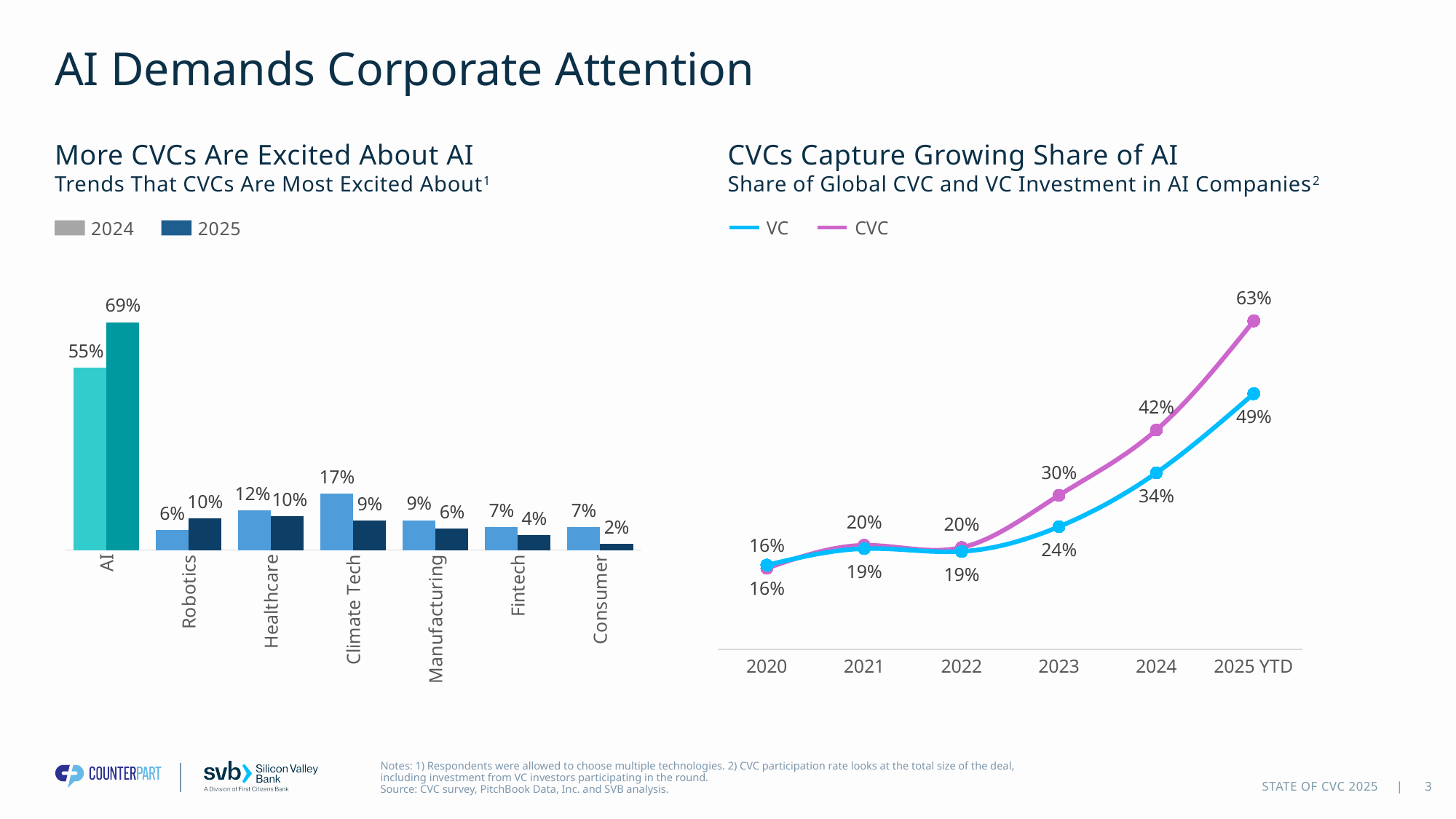
In the 'CVCs Capture Growing Share of AI' chart, what is the difference between the CVC and VC values in 2024? 8% In the 'More CVCs Are Excited About AI' chart, how many categories are shown on the x axis? 7 What kind of chart is 'More CVCs Are Excited About AI'? Bar chart In the 'More CVCs Are Excited About AI' chart, what is the difference between the 2025 and 2024 values for AI? 14% In the 'CVCs Capture Growing Share of AI' chart, what is the VC value for 2023? 24% In the 'More CVCs Are Excited About AI' chart, which is larger for Healthcare: the 2024 value or the 2025 value? 2024 In the 'More CVCs Are Excited About AI' chart, which category has the lowest 2025 value? Consumer In the 'CVCs Capture Growing Share of AI' chart, does the CVC line rise or fall from 2022 to 2025 YTD? Rise In the 'CVCs Capture Growing Share of AI' chart, what is the CVC value for 2025 YTD? 63% In the 'More CVCs Are Excited About AI' chart, what is the 2024 value for Climate Tech? 17% In the 'More CVCs Are Excited About AI' chart, what is the 2025 value for AI? 69% In the 'CVCs Capture Growing Share of AI' chart, how many series does the legend list? 2